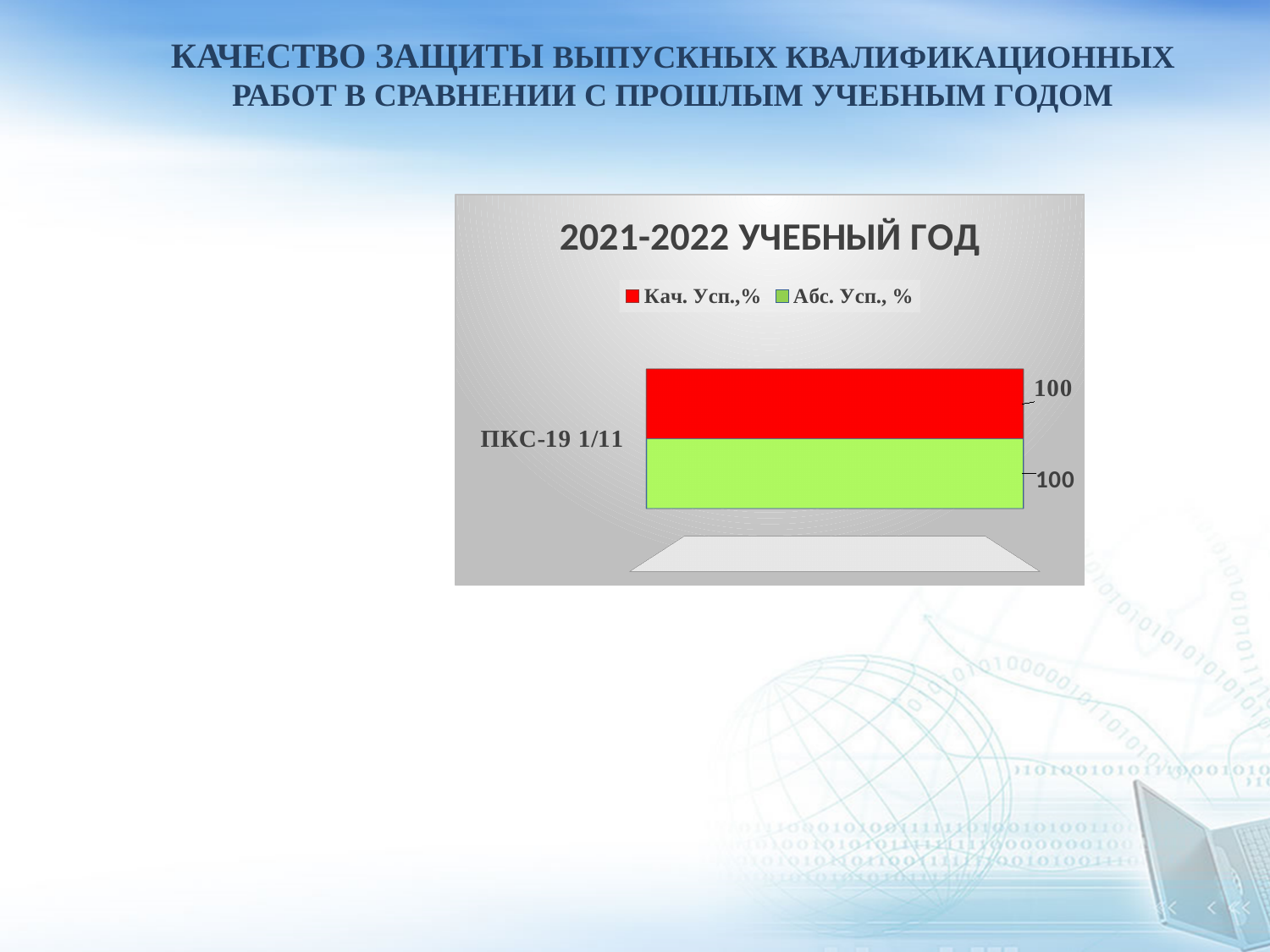
What is the name of the only category shown on the chart? ПКС-19 1/11 What is the title of the chart? 2021-2022 УЧЕБНЫЙ ГОД Which series is shown in red in the chart? Кач. Усп.,% What kind of chart is shown on the slide? Bar chart What is the difference between the Кач. Усп.,% and Абс. Усп., % values for ПКС-19 1/11? 0 What is the value of Кач. Усп.,% for ПКС-19 1/11? 100 How many series does the legend list? 2 How many categories are plotted on the chart? 1 What is the value of Абс. Усп., % for ПКС-19 1/11? 100